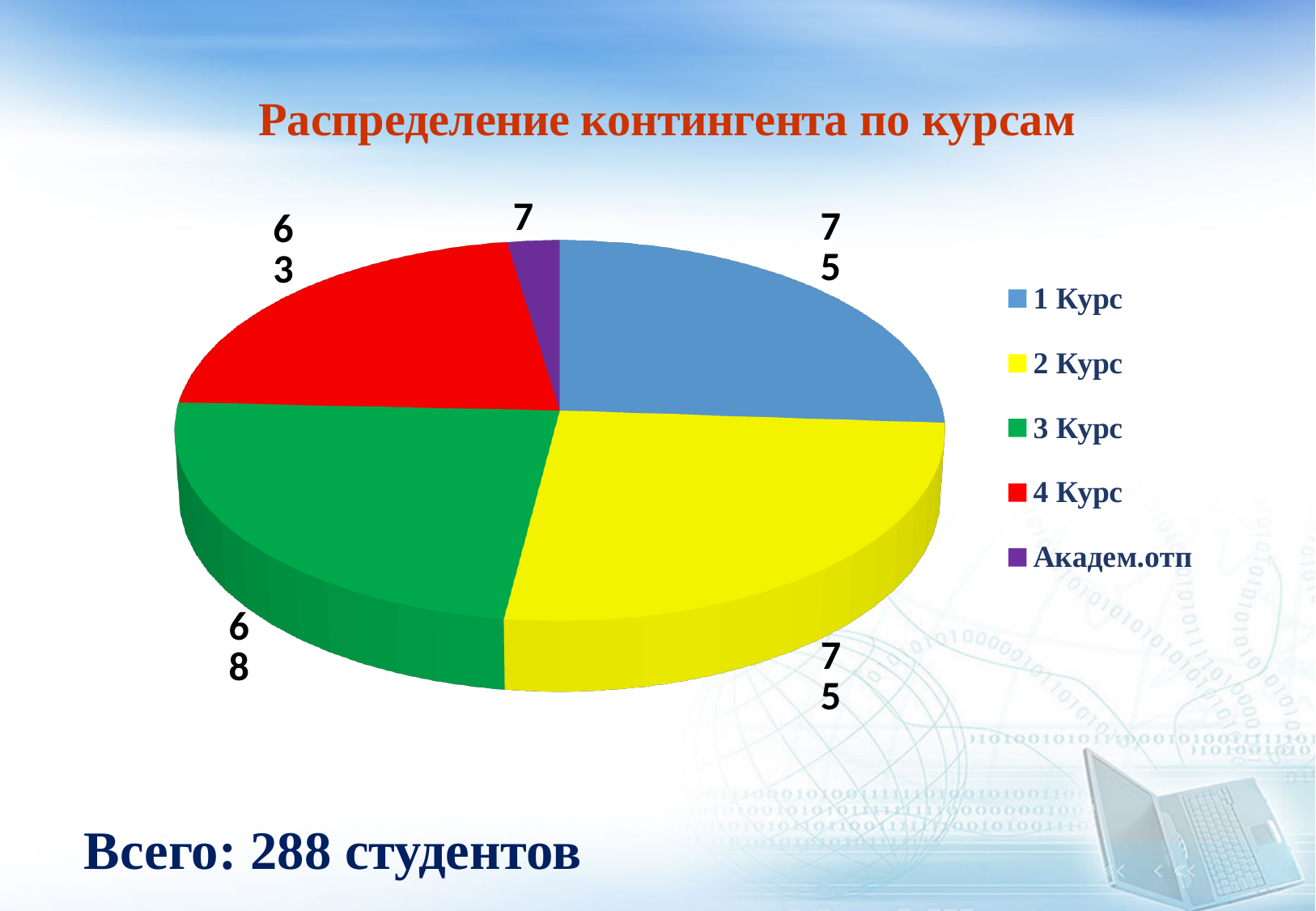
What is the value for Академ.отп? 7 What is the total number of students across all slices? 288 What is the title of the chart? Распределение контингента по курсам What type of chart is shown on the slide? pie chart How many slices does the pie chart have? 5 Which category has the smallest slice? Академ.отп What is the value for 3 Курс? 68 What is the value for 1 Курс? 75 What is the difference between the values for 3 Курс and 4 Курс? 5 How many entries does the legend list? 5 Which is larger, 3 Курс or 4 Курс? 3 Курс What is the value for 4 Курс? 63